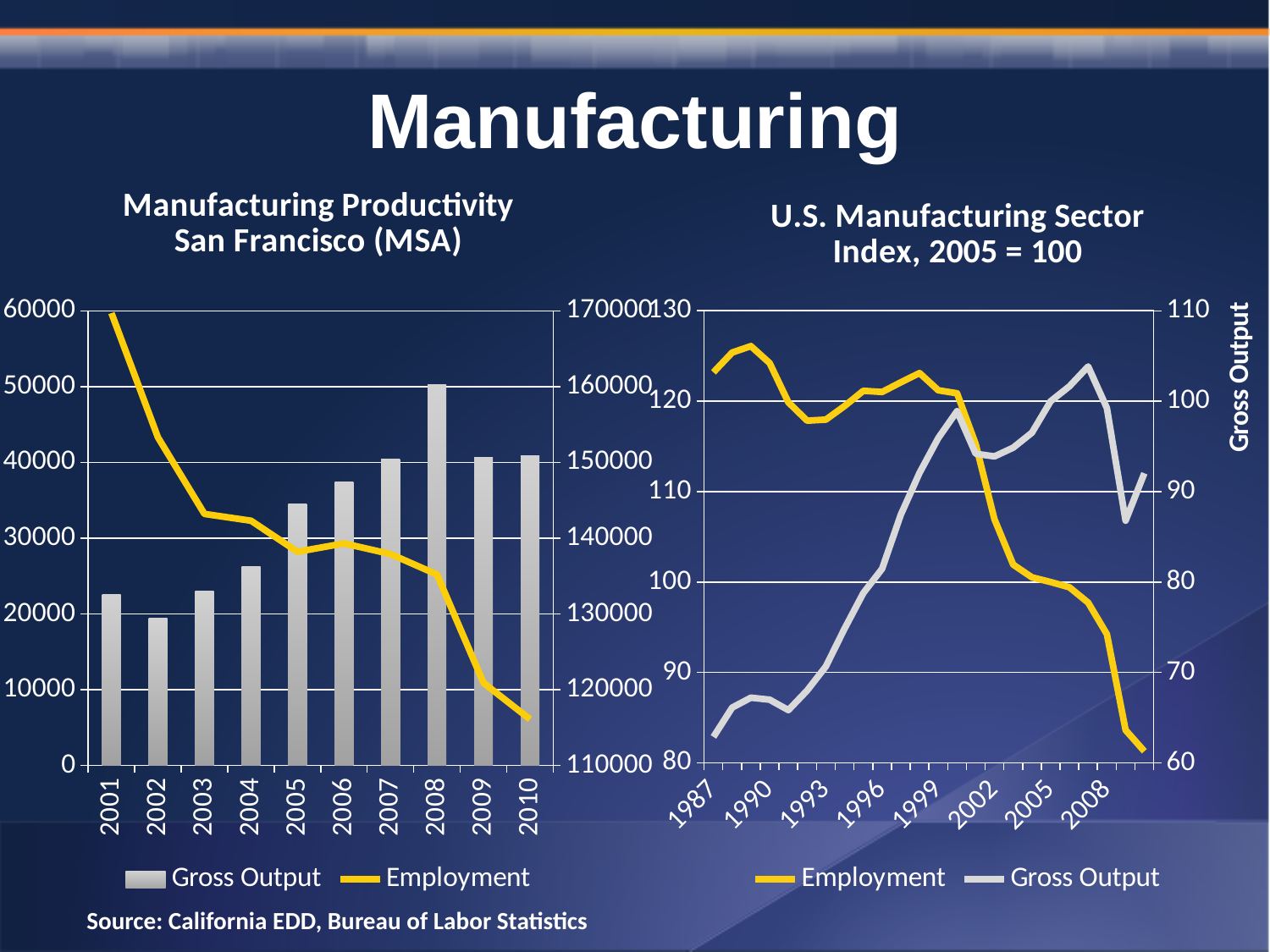
On the left chart (Manufacturing Productivity San Francisco (MSA)), how many years are shown on the x axis? 10 On the left chart (Manufacturing Productivity San Francisco (MSA)), is the Gross Output value for 2008 greater or less than 40000? greater On the left chart (Manufacturing Productivity San Francisco (MSA)), is the Gross Output value for 2005 greater or less than 30000? greater On the left chart (Manufacturing Productivity San Francisco (MSA)), which year has the lowest Gross Output bar? 2002 On the left chart (Manufacturing Productivity San Francisco (MSA)), does the Employment line rise or fall from 2001 to 2010? fall On the left chart (Manufacturing Productivity San Francisco (MSA)), which year has the highest Gross Output bar? 2008 On the right chart (U.S. Manufacturing Sector Index, 2005 = 100), does the Employment line rise or fall overall from 1987 to the end of the series? fall On the right chart (U.S. Manufacturing Sector Index, 2005 = 100), is the Employment value for 1987 greater or less than 120? greater On the right chart (U.S. Manufacturing Sector Index, 2005 = 100), what type of chart is it? line chart On the left chart (Manufacturing Productivity San Francisco (MSA)), how many series does the legend list? 2 On the left chart (Manufacturing Productivity San Francisco (MSA)), which series is drawn as bars? Gross Output